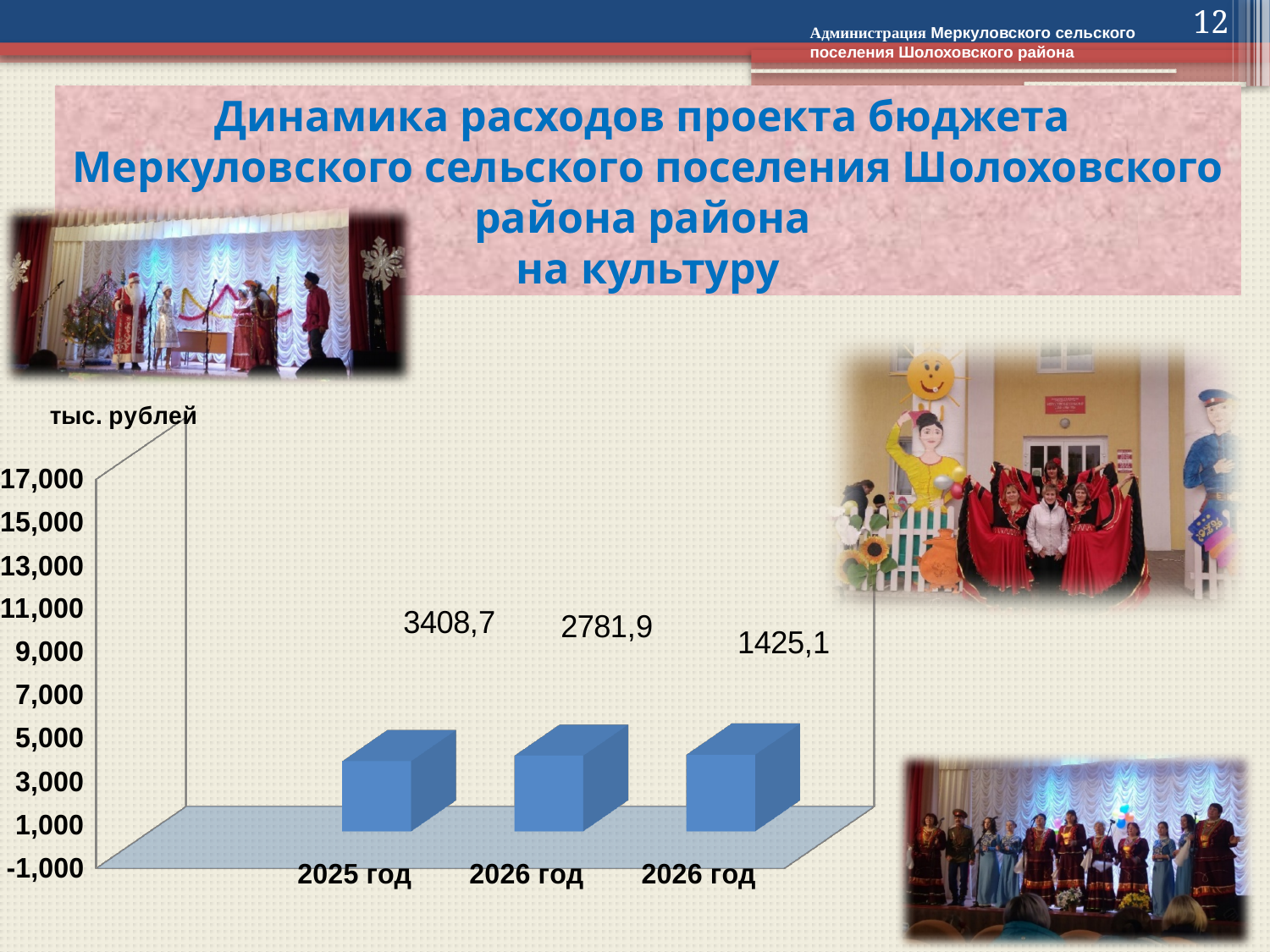
Which is larger: the value for 2025 год or the value on the rightmost bar? 2025 год What is the data label on the middle bar of the chart? 2781,9 What is the difference between the value on the middle bar and the value on the rightmost bar? 1356,8 What is the data label on the rightmost bar of the chart? 1425,1 What kind of chart is shown on the slide? Bar chart Which bar has the lowest value? The rightmost bar (1425,1) What is the value shown for 2025 год? 3408,7 Is the value for 2025 год greater or less than 9,000? less What is the difference between the value for 2025 год and the value on the middle bar? 626,8 How many bars are plotted in the chart? 3 Which bar has the highest value? 2025 год (the leftmost bar)